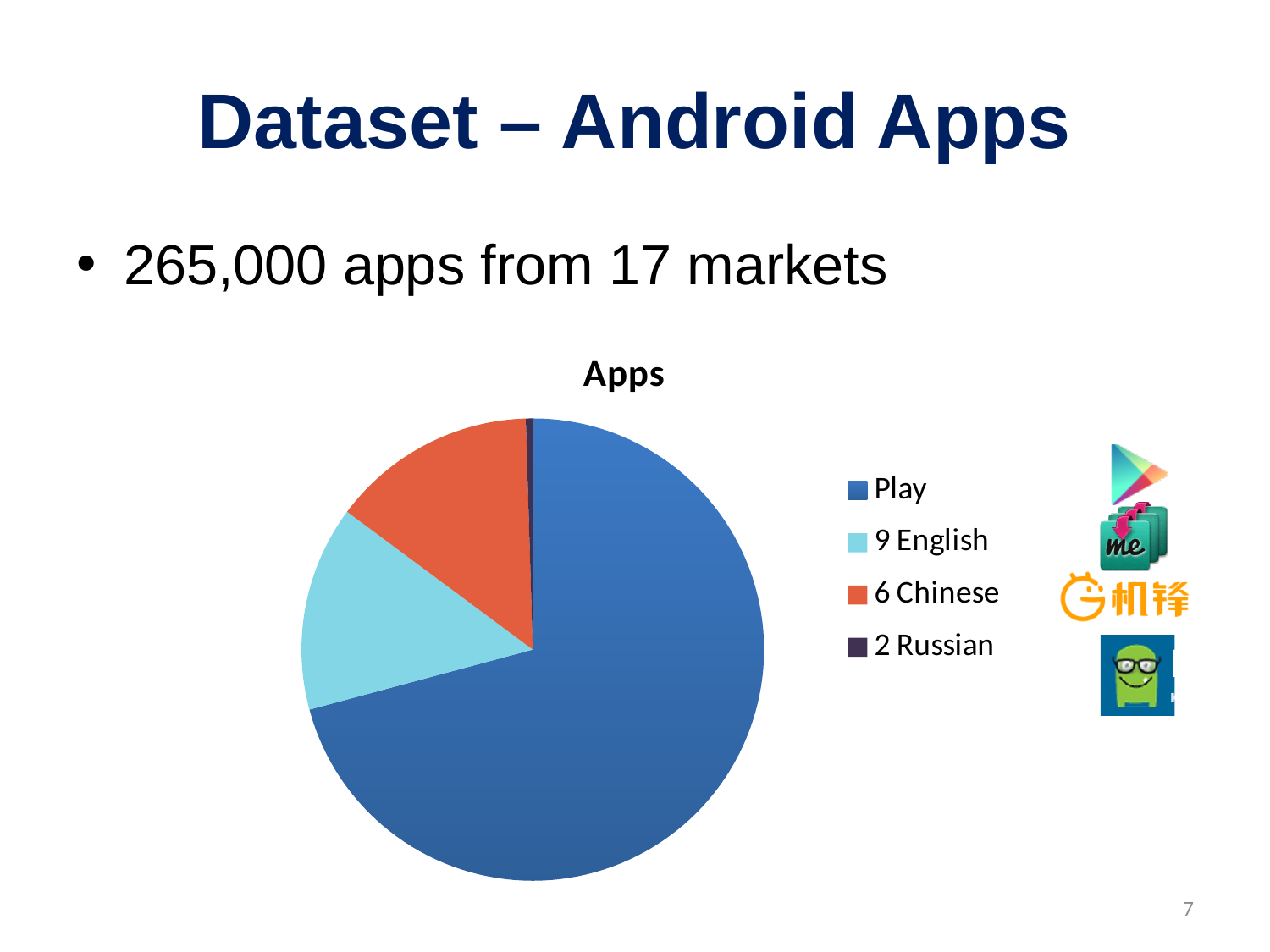
Which category has the smallest slice of the pie? 2 Russian Which slice is larger, 6 Chinese or 2 Russian? 6 Chinese What kind of chart is shown on the slide? pie chart How many slices does the pie chart have? 4 Does the Play slice take up more or less than half of the pie? more Which slice is larger, Play or 9 English? Play Which category has the largest slice of the pie? Play What is the title of the chart? Apps Which category is shown in orange-red in the pie chart? 6 Chinese How many entries does the chart legend list? 4